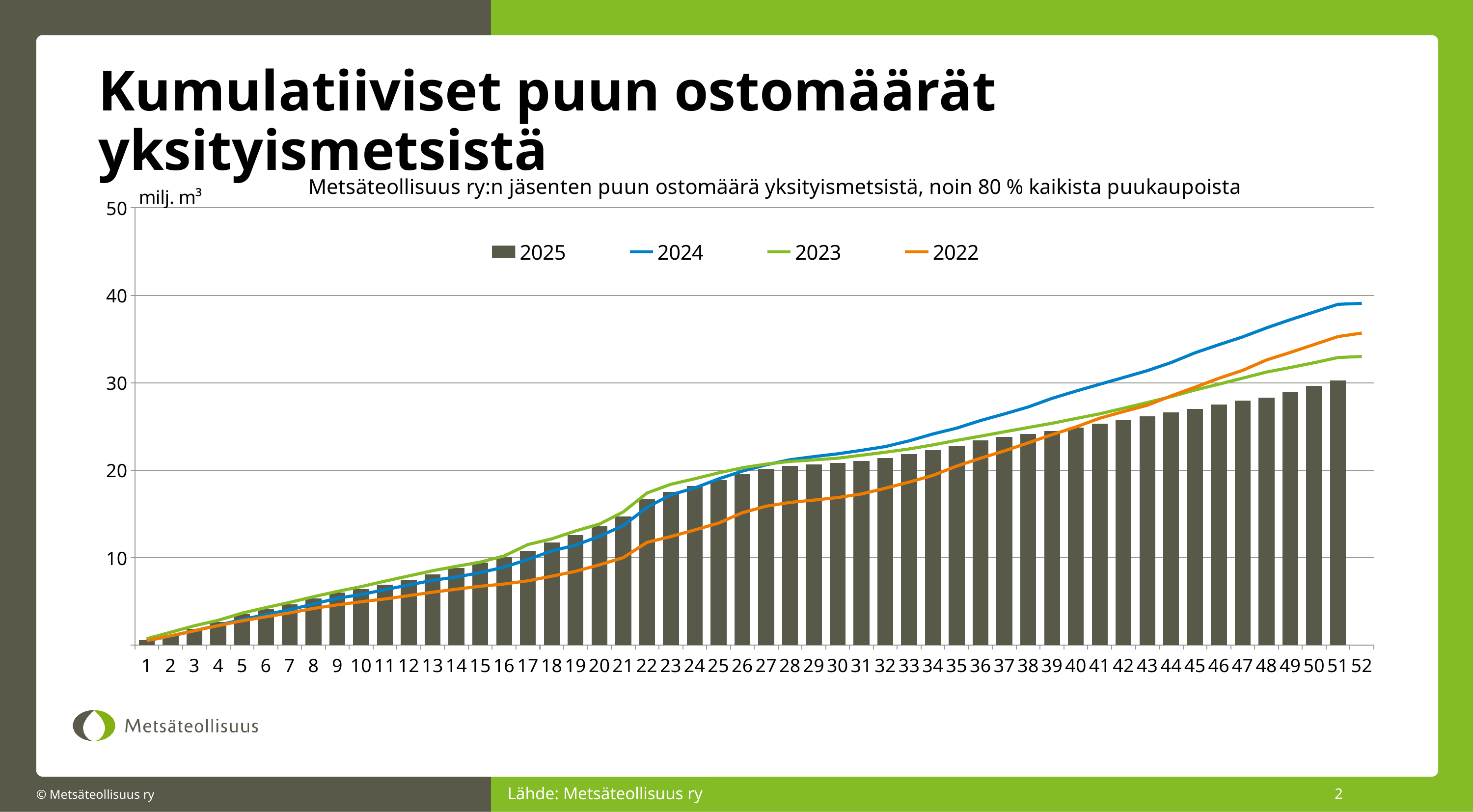
What kind of chart is this? Combined bar and line chart How many week categories are labelled on the x axis? 52 Is the value of the 2025 bar at week 10 greater or less than 10? less Which series is shown as bars rather than a line? 2025 Do the values for the 2024 line rise or fall along the x axis? Rise How many series does the legend list? 4 At week 52, which is larger: the 2022 line or the 2023 line? 2022 Is the value of the 2024 line at week 52 greater or less than 40? less Is the value of the 2023 line at week 52 greater or less than 30? greater What unit is shown on the y axis? milj. m³ Which series has the highest value at week 52? 2024